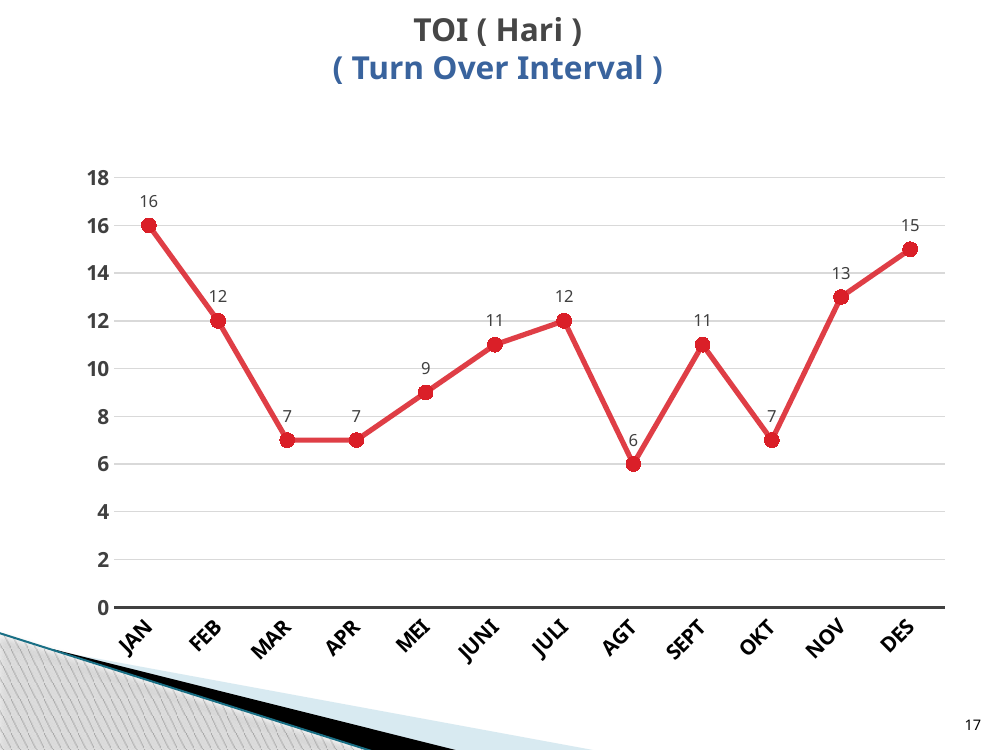
How many months are plotted on the chart? 12 What is the title of the chart? TOI ( Hari ) ( Turn Over Interval ) Which month has a larger TOI value, FEB or MEI? FEB Which month has the highest TOI value? JAN What is the difference between the TOI values for JULI and AGT? 6 What is the TOI value for JAN? 16 What is the difference between the TOI values for JAN and DES? 1 What is the TOI value for NOV? 13 Do the TOI values rise or fall from JAN to MAR? Fall What is the TOI value for AGT? 6 What kind of chart is shown on the slide? Line chart Which month has the lowest TOI value? AGT